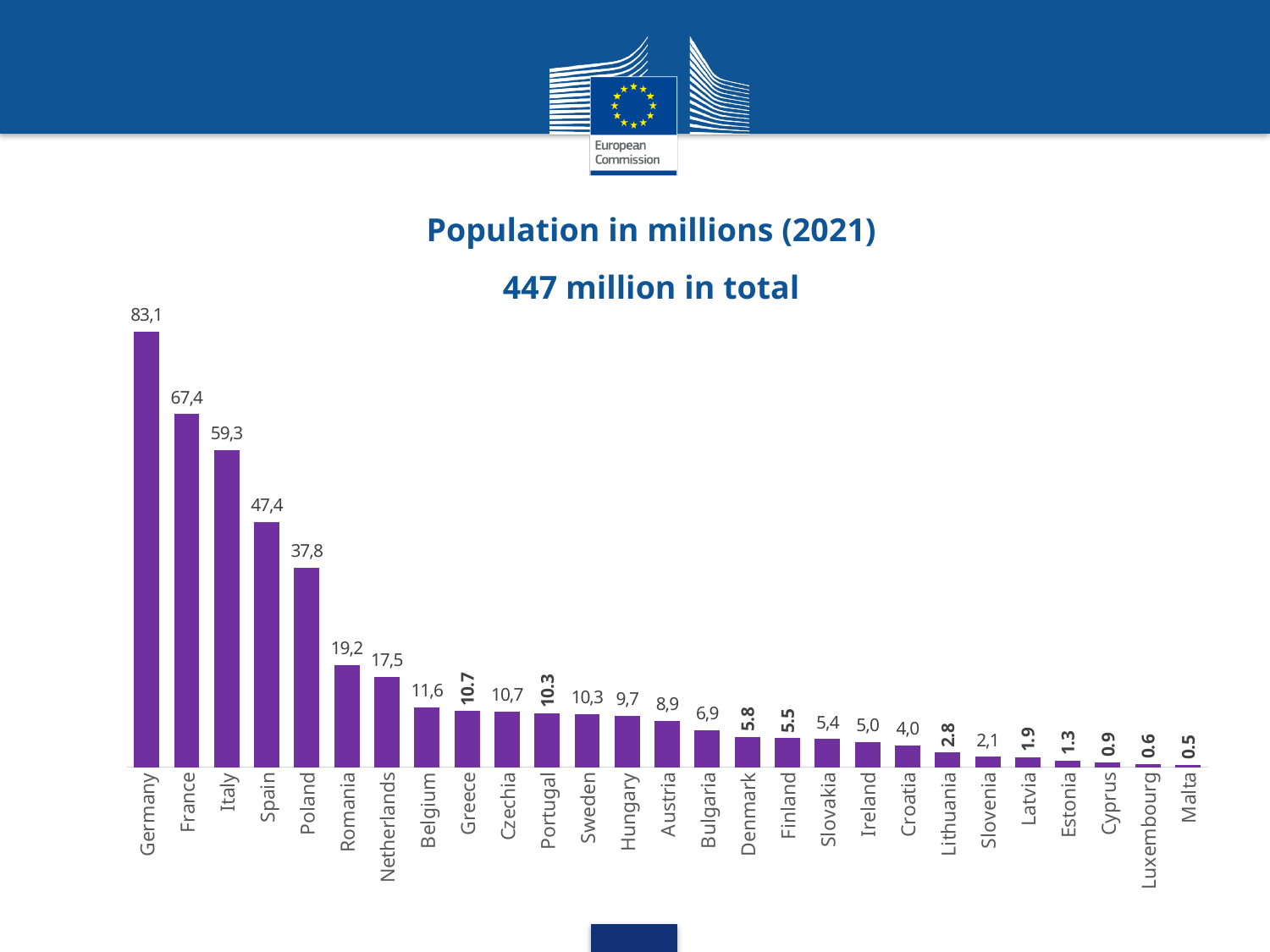
What is the population value shown for Luxembourg? 0.6 Which country has the highest population in the chart? Germany What kind of chart is shown on the slide? Bar chart What is the difference between the population values of Germany and France? 15,7 What is the population value shown for Germany? 83,1 Which country has the lowest population in the chart? Malta What is the population value shown for Poland? 37,8 How many countries are shown in the chart? 27 What is the population value shown for Denmark? 5.8 Do the population values rise or fall from left to right across the chart? Fall What is the title of the chart? Population in millions (2021) Which has the larger population value, Romania or the Netherlands? Romania